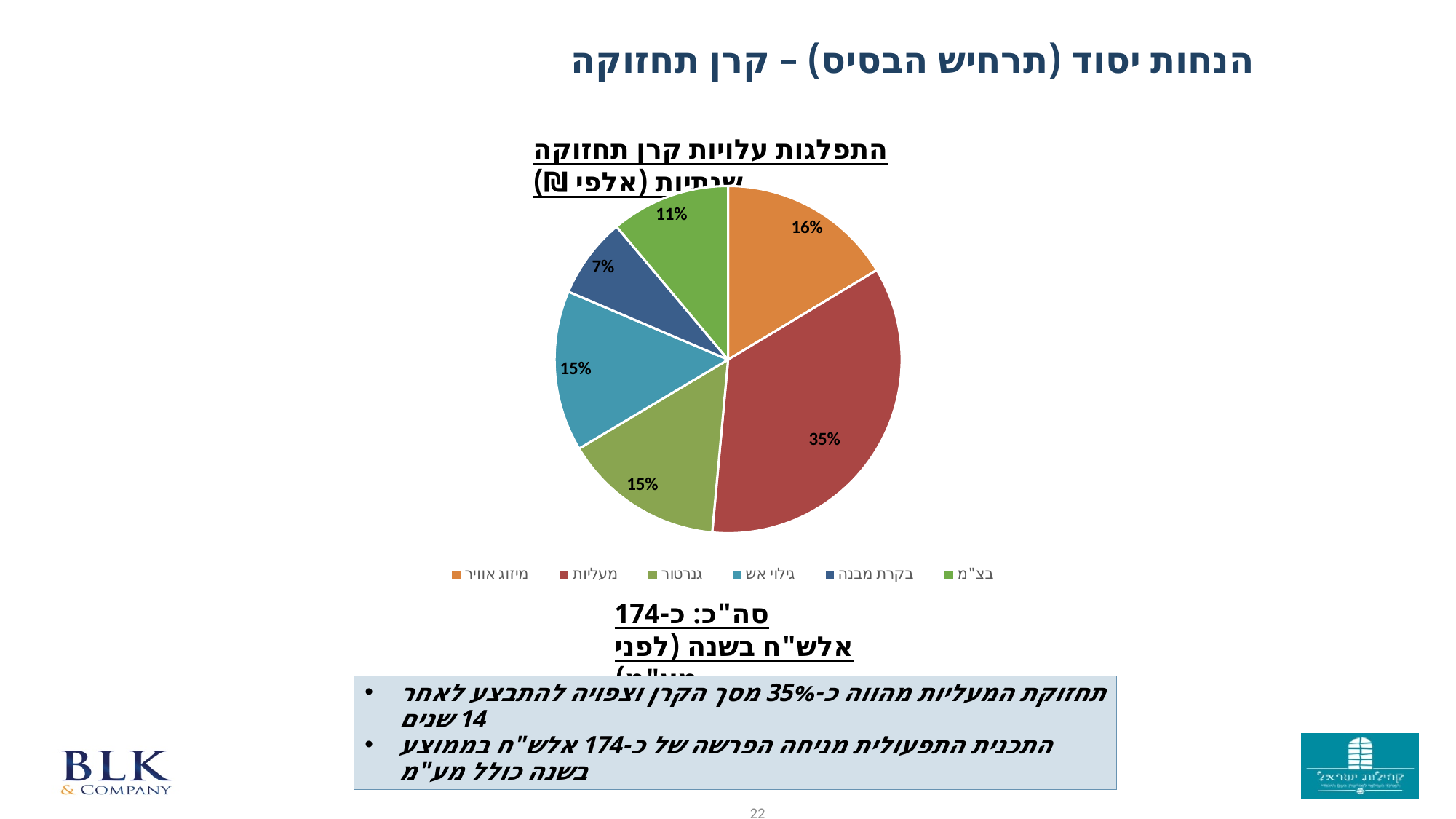
What is the difference in percentage points between the מעליות share and the מיזוג אוויר share? 19 What share of the pie does בקרת מבנה (building control) account for? 7% What share of the pie does בצ"מ account for? 11% Which category has the smallest share of the pie? בקרת מבנה Which category has the largest share of the pie? מעליות What kind of chart is shown on the slide? pie chart What colour is the slice for מעליות? red What share of the pie does מיזוג אוויר (air conditioning) account for? 16% How many categories does the legend list? 6 What share of the pie does גילוי אש (fire detection) account for? 15% What share of the pie does מעליות (elevators) account for? 35% Which is larger, the share for בצ"מ or the share for בקרת מבנה? בצ"מ